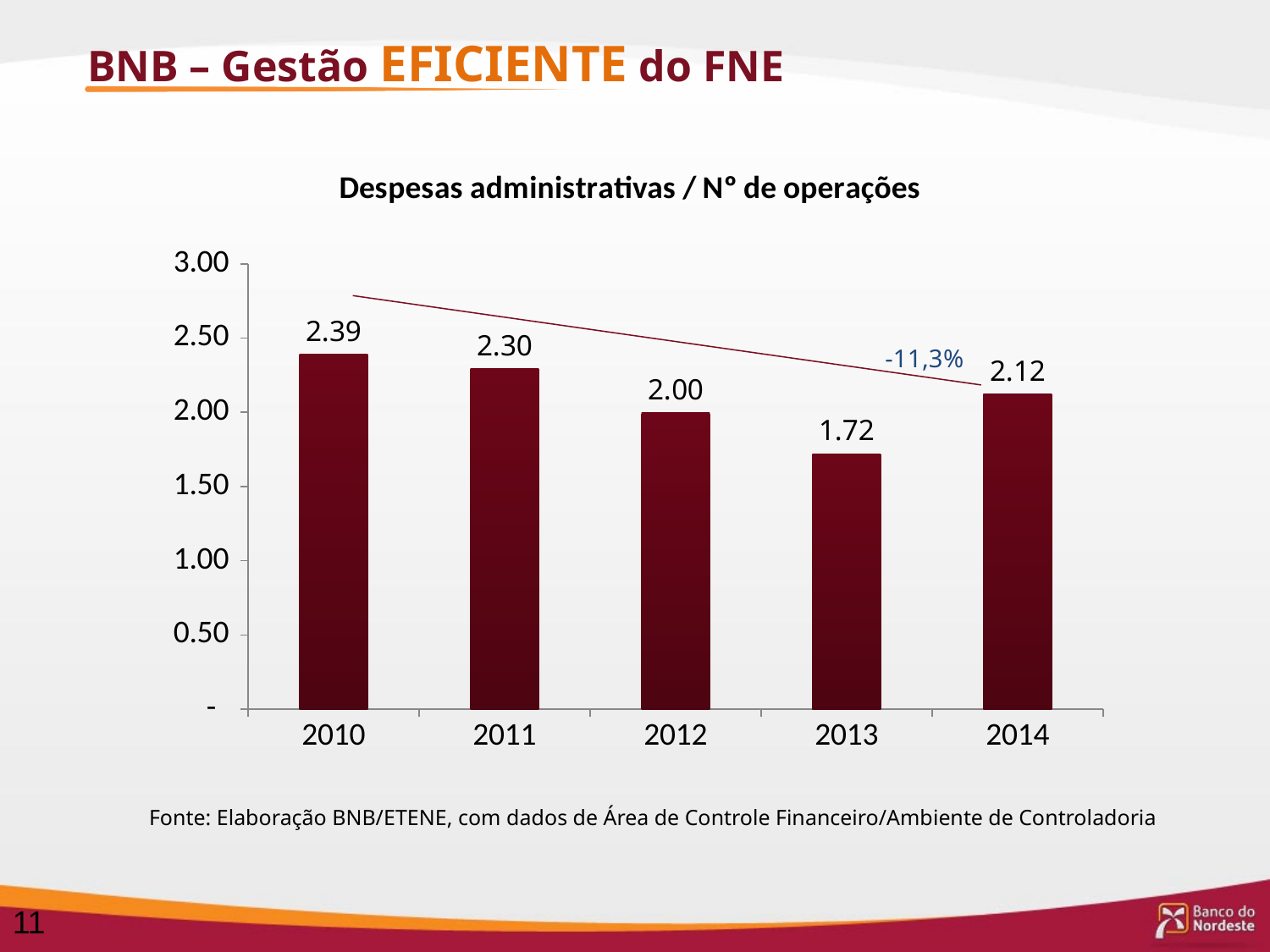
What is the value for 2010? 2.39 What is the difference between the values for 2010 and 2014? 0.27 What kind of chart is shown on the slide? bar chart What is the title of the chart? Despesas administrativas / Nº de operações Is the value for 2013 greater or less than 2.00? less What is the difference between the values for 2012 and 2013? 0.28 Which year has the highest value? 2010 How many years are shown on the x axis? 5 What is the value for 2014? 2.12 What is the value for 2013? 1.72 Which year has the lowest value? 2013 Which is larger, the value for 2011 or the value for 2014? 2011